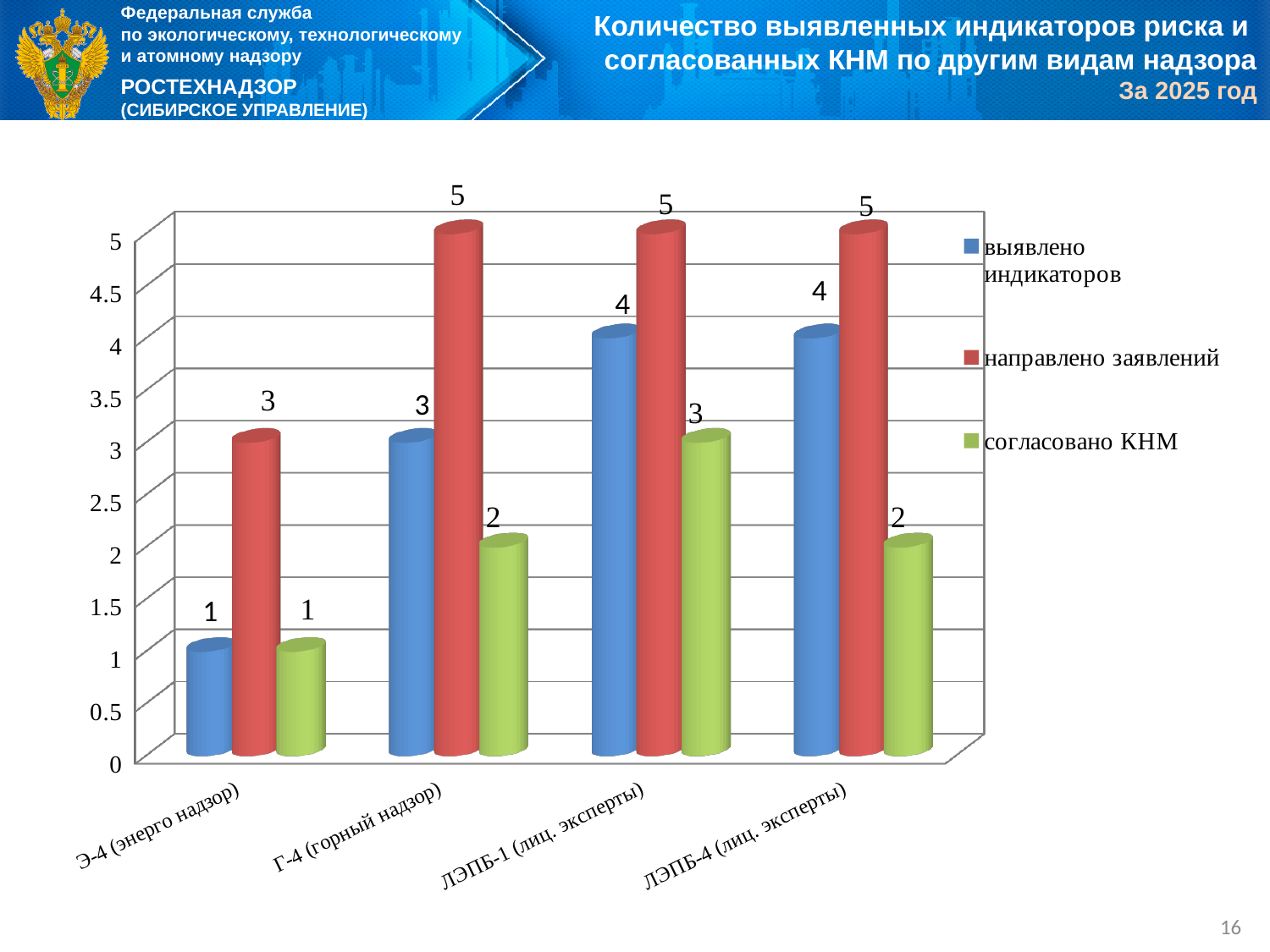
What is the value of "выявлено индикаторов" for Э-4 (энерго надзор)? 1 What is the value of "выявлено индикаторов" for ЛЭПБ-4 (лиц. эксперты)? 4 What kind of chart is shown on the slide? Bar chart Which category has the highest value for "согласовано КНМ"? ЛЭПБ-1 (лиц. эксперты) What is the difference between "направлено заявлений" and "согласовано КНМ" for Г-4 (горный надзор)? 3 Which colour represents "согласовано КНМ" in the legend? Green How many categories are shown on the x axis? 4 Which category has the lowest value for "направлено заявлений"? Э-4 (энерго надзор) What is the value of "согласовано КНМ" for ЛЭПБ-1 (лиц. эксперты)? 3 What is the value of "направлено заявлений" for Г-4 (горный надзор)? 5 How many series does the legend list? 3 Which is larger for ЛЭПБ-4 (лиц. эксперты): "выявлено индикаторов" or "согласовано КНМ"? выявлено индикаторов